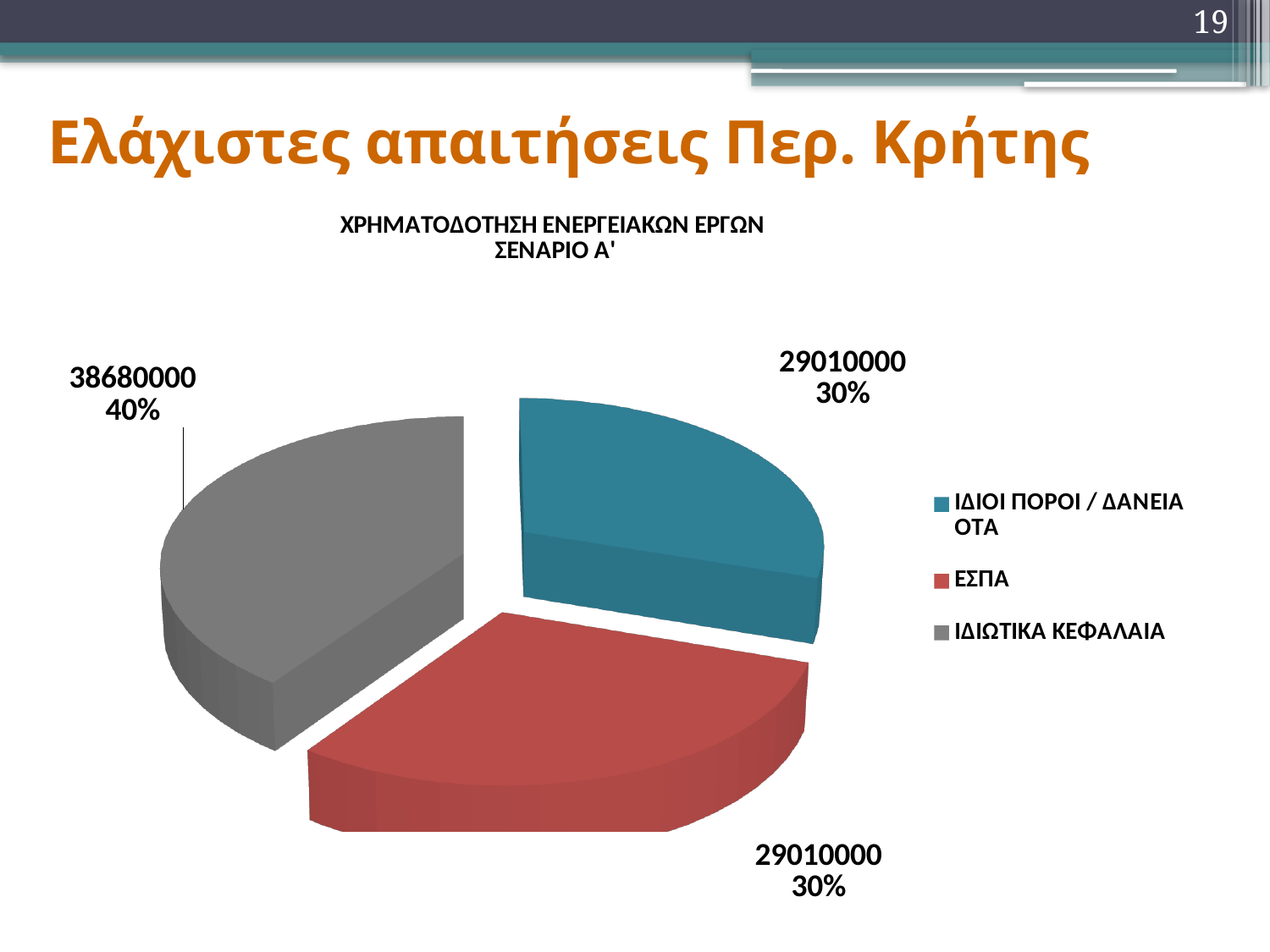
How many slices does the pie chart have? 3 What is the title of the chart? ΧΡΗΜΑΤΟΔΟΤΗΣΗ ΕΝΕΡΓΕΙΑΚΩΝ ΕΡΓΩΝ ΣΕΝΑΡΙΟ Α' What is the total of all three slices in the pie chart? 96700000 What share of the pie does ΕΣΠΑ represent? 30% Which category has the largest slice of the pie? ΙΔΙΩΤΙΚΑ ΚΕΦΑΛΑΙΑ What type of chart is shown on the slide? Pie chart What is the value for ΙΔΙΩΤΙΚΑ ΚΕΦΑΛΑΙΑ? 38680000 What is the value for ΙΔΙΟΙ ΠΟΡΟΙ / ΔΑΝΕΙΑ ΟΤΑ? 29010000 Which is larger, the value for ΙΔΙΩΤΙΚΑ ΚΕΦΑΛΑΙΑ or the value for ΙΔΙΟΙ ΠΟΡΟΙ / ΔΑΝΕΙΑ ΟΤΑ? ΙΔΙΩΤΙΚΑ ΚΕΦΑΛΑΙΑ What is the difference between the values for ΙΔΙΩΤΙΚΑ ΚΕΦΑΛΑΙΑ and ΕΣΠΑ? 9670000 What is the value for ΕΣΠΑ? 29010000 What share of the pie does ΙΔΙΩΤΙΚΑ ΚΕΦΑΛΑΙΑ represent? 40%